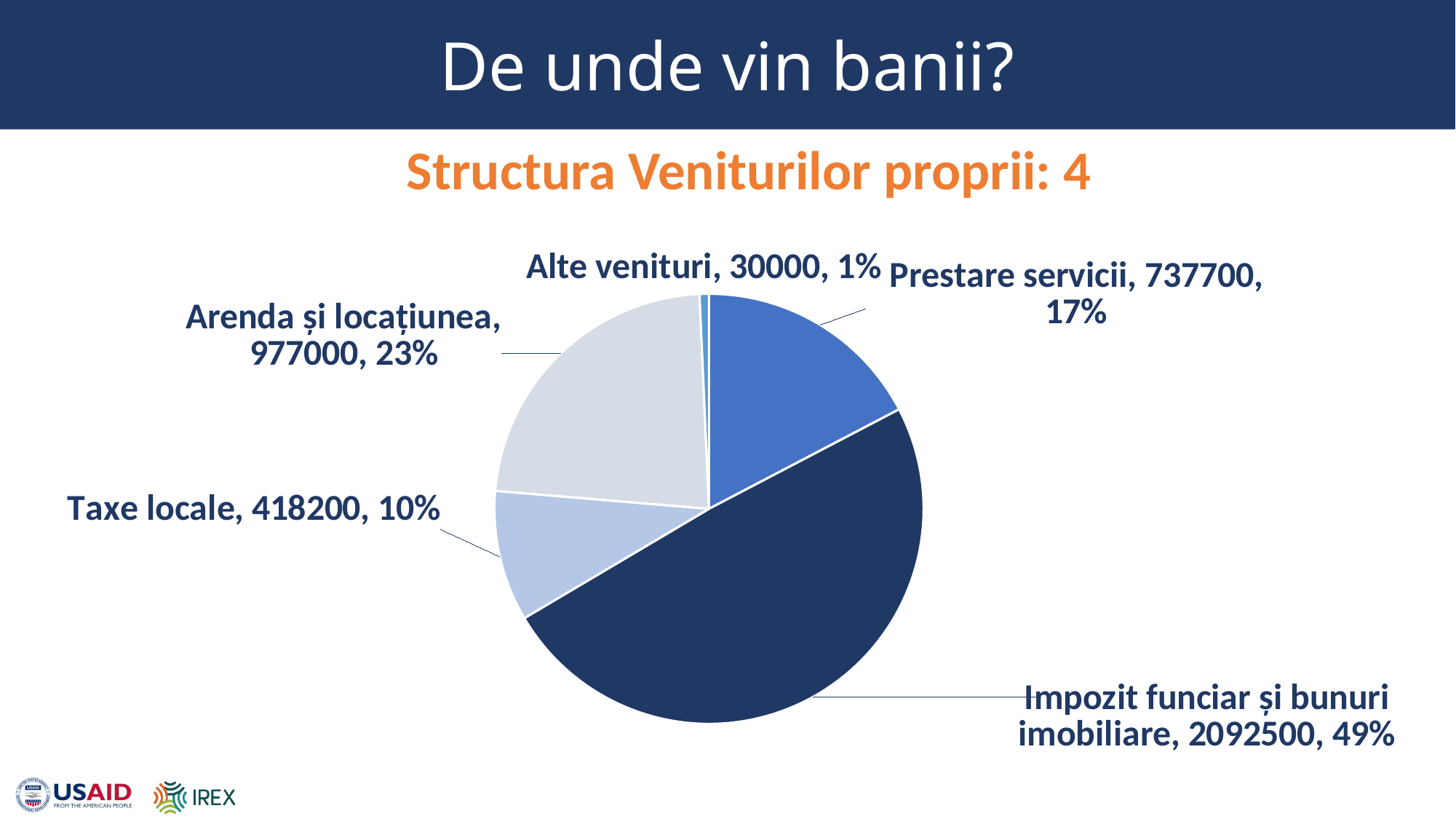
What is the value for Impozit funciar și bunuri imobiliare? 2092500 Which category has the largest slice? Impozit funciar și bunuri imobiliare What is the value for Arenda și locațiunea? 977000 What kind of chart is shown on the slide? pie chart What share of the pie does Prestare servicii represent? 17% What is the value for Taxe locale? 418200 What share of the pie does Alte venituri represent? 1% Which category has the smallest slice? Alte venituri Which is larger, the value for Taxe locale or the value for Prestare servicii? Prestare servicii What is the difference between the values for Arenda și locațiunea and Prestare servicii? 239300 How many slices does the pie chart have? 5 What is the title of the chart? Structura Veniturilor proprii: 4